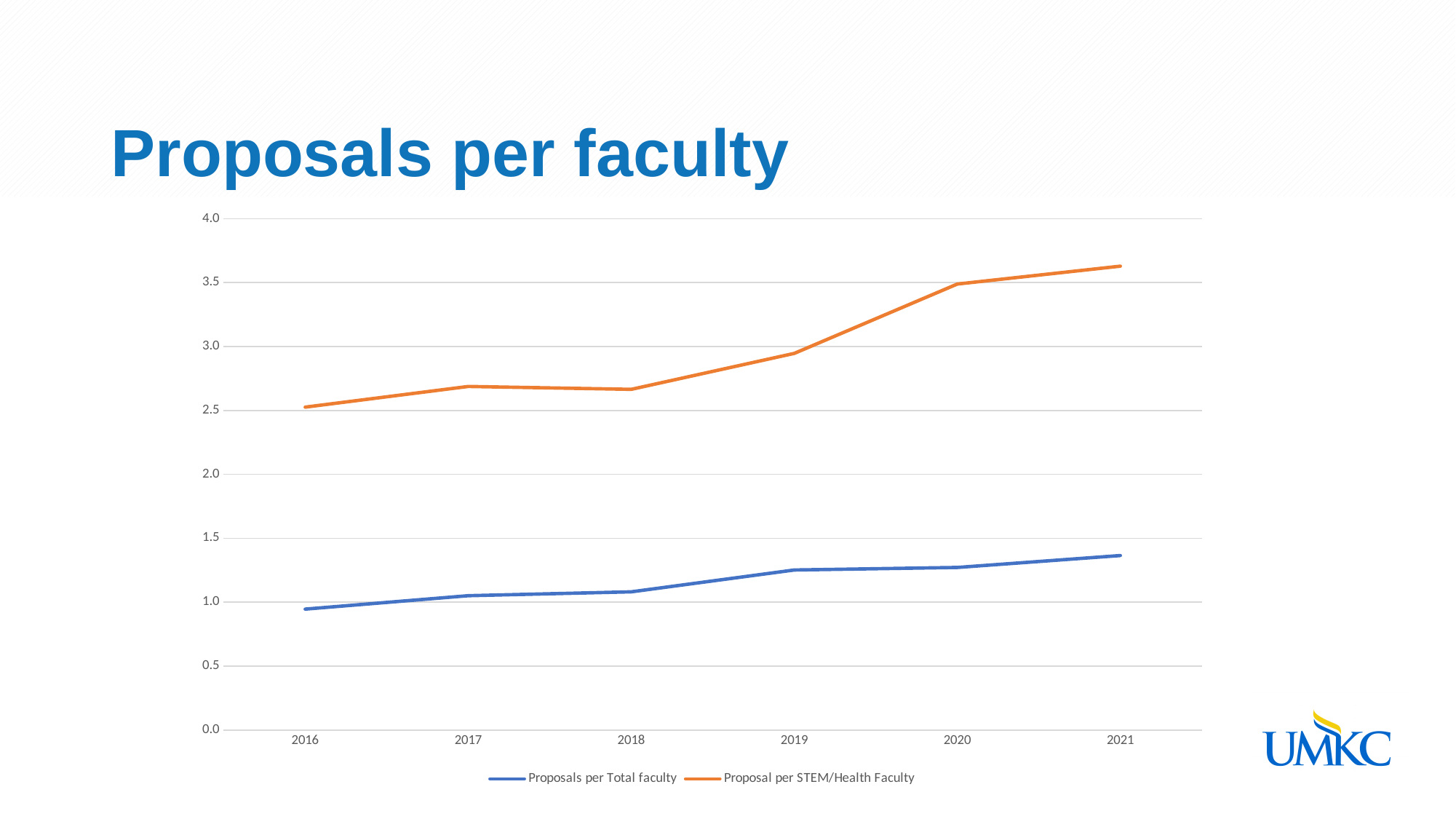
In which year is the value for Proposals per Total faculty lowest? 2016 Is the value for Proposal per STEM/Health Faculty in 2016 greater or less than 3.0? less Is the value for Proposal per STEM/Health Faculty in 2020 greater or less than 3.0? greater In which year is the value for Proposal per STEM/Health Faculty highest? 2021 What kind of chart is shown on the slide? line chart How many series does the legend list? 2 Do the values for Proposal per STEM/Health Faculty generally rise or fall from 2016 to 2021? rise How many years are plotted along the x axis? 6 Is the value for Proposals per Total faculty in 2021 greater or less than 1.0? greater What is the title of the chart? Proposals per faculty Which series has the larger value in 2021, Proposals per Total faculty or Proposal per STEM/Health Faculty? Proposal per STEM/Health Faculty